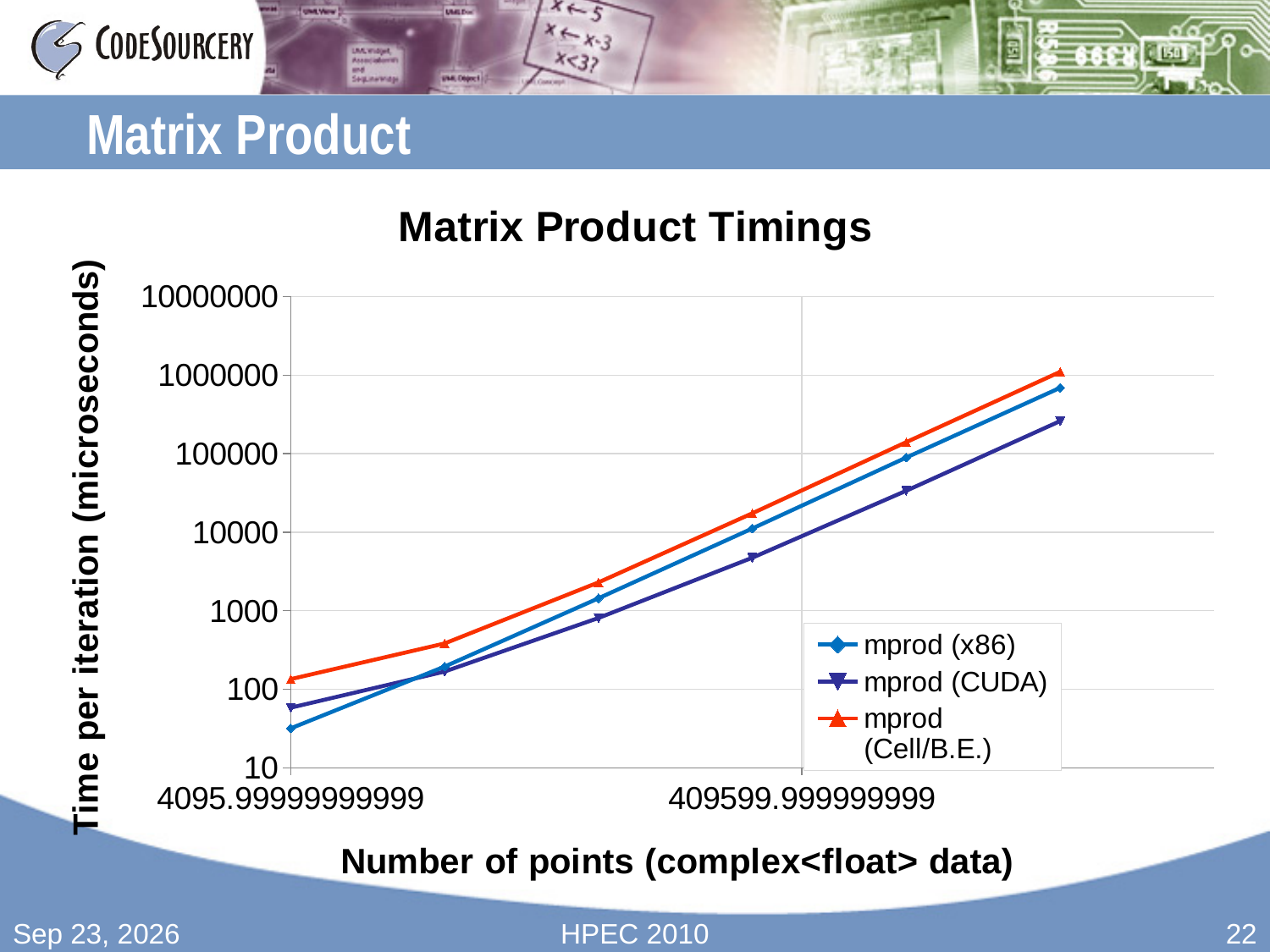
What is the title of the chart? Matrix Product Timings What is the label of the vertical axis? Time per iteration (microseconds) What kind of chart is shown on the slide? line chart At the rightmost data point, is the value for mprod (CUDA) greater or less than 1000000? less At the leftmost data point, is the value for mprod (x86) greater or less than 100? less Which series has the highest time per iteration at the largest number of points? mprod (Cell/B.E.) Do the values for mprod (CUDA) rise or fall as the number of points increases? rise At the leftmost data point, is the value for mprod (Cell/B.E.) greater or less than 100? greater How many data points are plotted for the mprod (x86) series? 6 At the leftmost data point, which is larger: mprod (CUDA) or mprod (x86)? mprod (CUDA) How many series does the legend of the Matrix Product Timings chart list? 3 Which series has the lowest time per iteration at the largest number of points? mprod (CUDA)